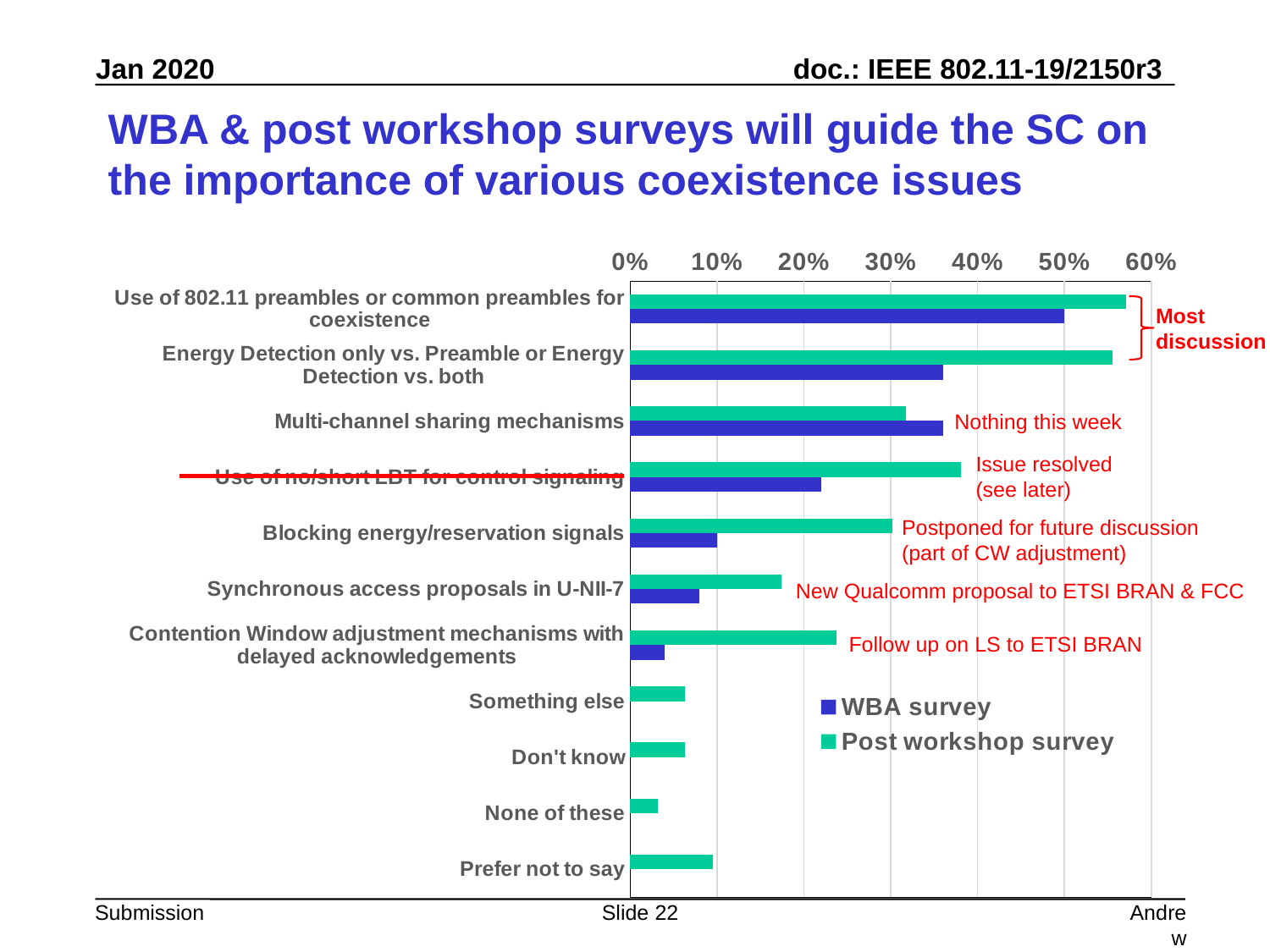
Which category has the highest value in the WBA survey series? Use of 802.11 preambles or common preambles for coexistence Is the Post workshop survey value for 'Energy Detection only vs. Preamble or Energy Detection vs. both' greater or less than 50%? greater For 'Contention Window adjustment mechanisms with delayed acknowledgements', which series has the larger value: WBA survey or Post workshop survey? Post workshop survey Is the WBA survey value for 'Blocking energy/reservation signals' greater or less than 20%? less Is the WBA survey value for 'Use of 802.11 preambles or common preambles for coexistence' greater or less than 40%? greater For 'Energy Detection only vs. Preamble or Energy Detection vs. both', which series has the larger value: WBA survey or Post workshop survey? Post workshop survey How many categories are shown on the vertical axis of the chart? 11 How many series does the legend list? 2 Which category has the highest value in the Post workshop survey series? Use of 802.11 preambles or common preambles for coexistence What kind of chart is shown on the slide? bar chart Which category has the lowest Post workshop survey value? None of these What colour represents the WBA survey series in the chart? blue